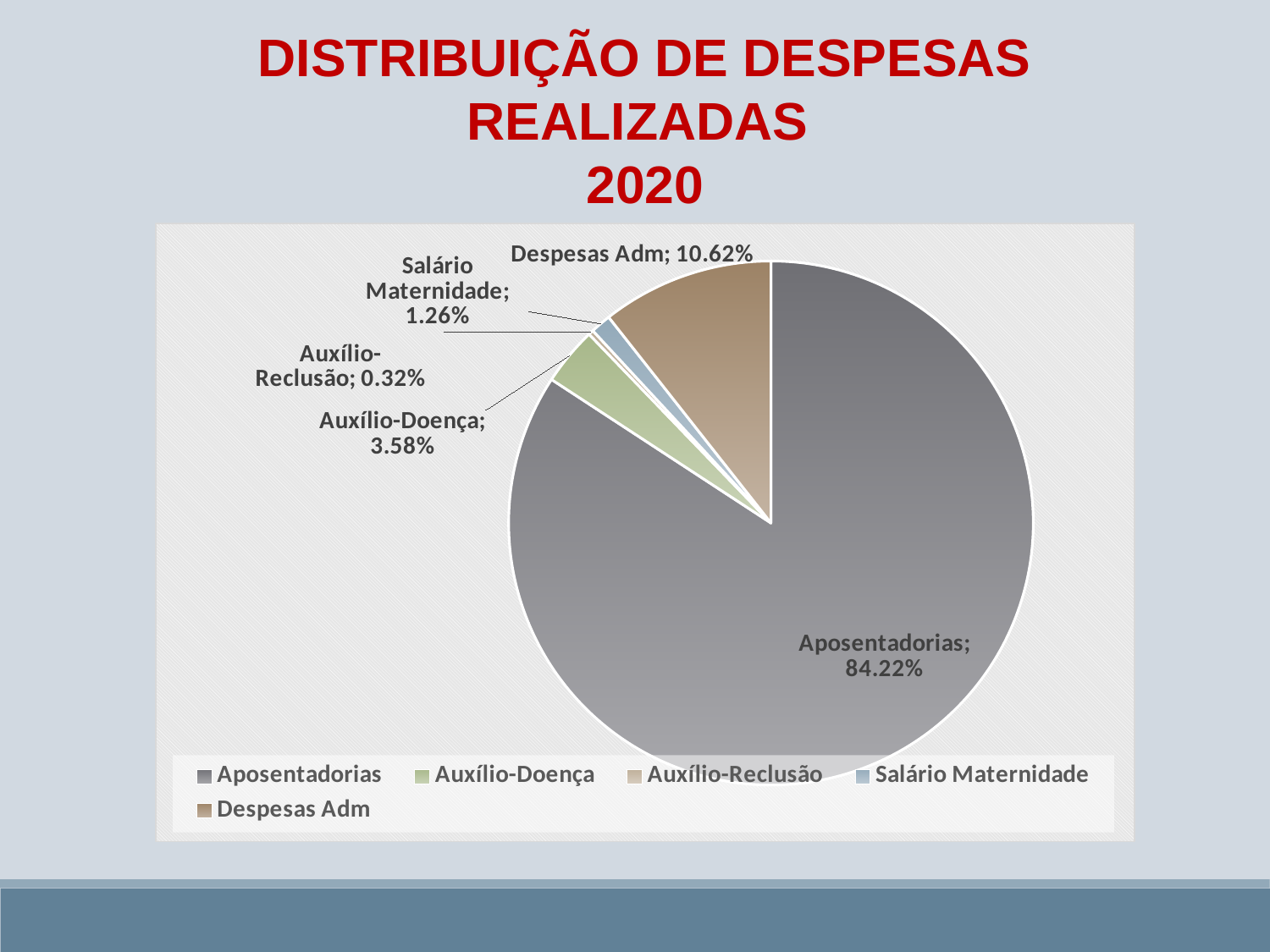
What is the title of the slide? DISTRIBUIÇÃO DE DESPESAS REALIZADAS 2020 What is the value for Auxílio-Reclusão? 0.32% What is the value shown for Despesas Adm? 10.62% What is the value for Salário Maternidade? 1.26% How many categories are shown in the pie chart? 5 What kind of chart is shown on the slide? Pie chart Which category has the smallest slice of the pie? Auxílio-Reclusão What is the difference between the shares of Despesas Adm and Auxílio-Doença? 7.04% What percentage is shown for Auxílio-Doença? 3.58% What share of the pie does Aposentadorias represent? 84.22% Which is larger, the share for Salário Maternidade or the share for Auxílio-Reclusão? Salário Maternidade Which category has the largest slice of the pie? Aposentadorias